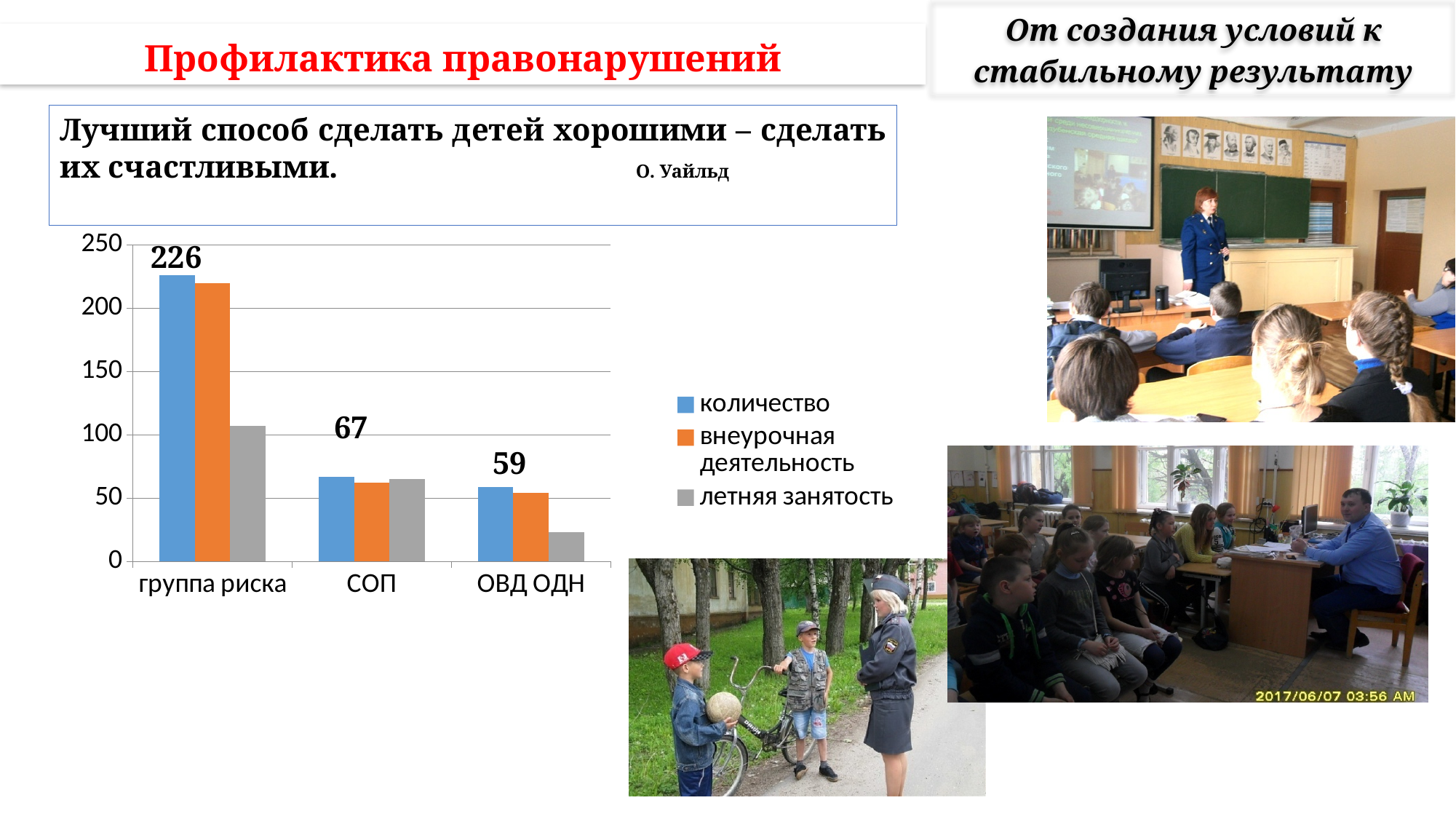
What is the difference between the количество values for группа риска and СОП? 159 Is the value for летняя занятость in группа риска greater or less than 150? less Which category has the highest value for количество? группа риска Which category has the lowest value for количество? ОВД ОДН What is the value of количество for ОВД ОДН? 59 What is the value of количество for СОП? 67 How many categories are shown on the x axis of the chart? 3 Is the value for летняя занятость in ОВД ОДН greater or less than 50? less Which category has the larger value for летняя занятость: группа риска or ОВД ОДН? группа риска What is the value of количество for группа риска? 226 What is the difference between the количество values for СОП and ОВД ОДН? 8 How many series does the chart legend list? 3